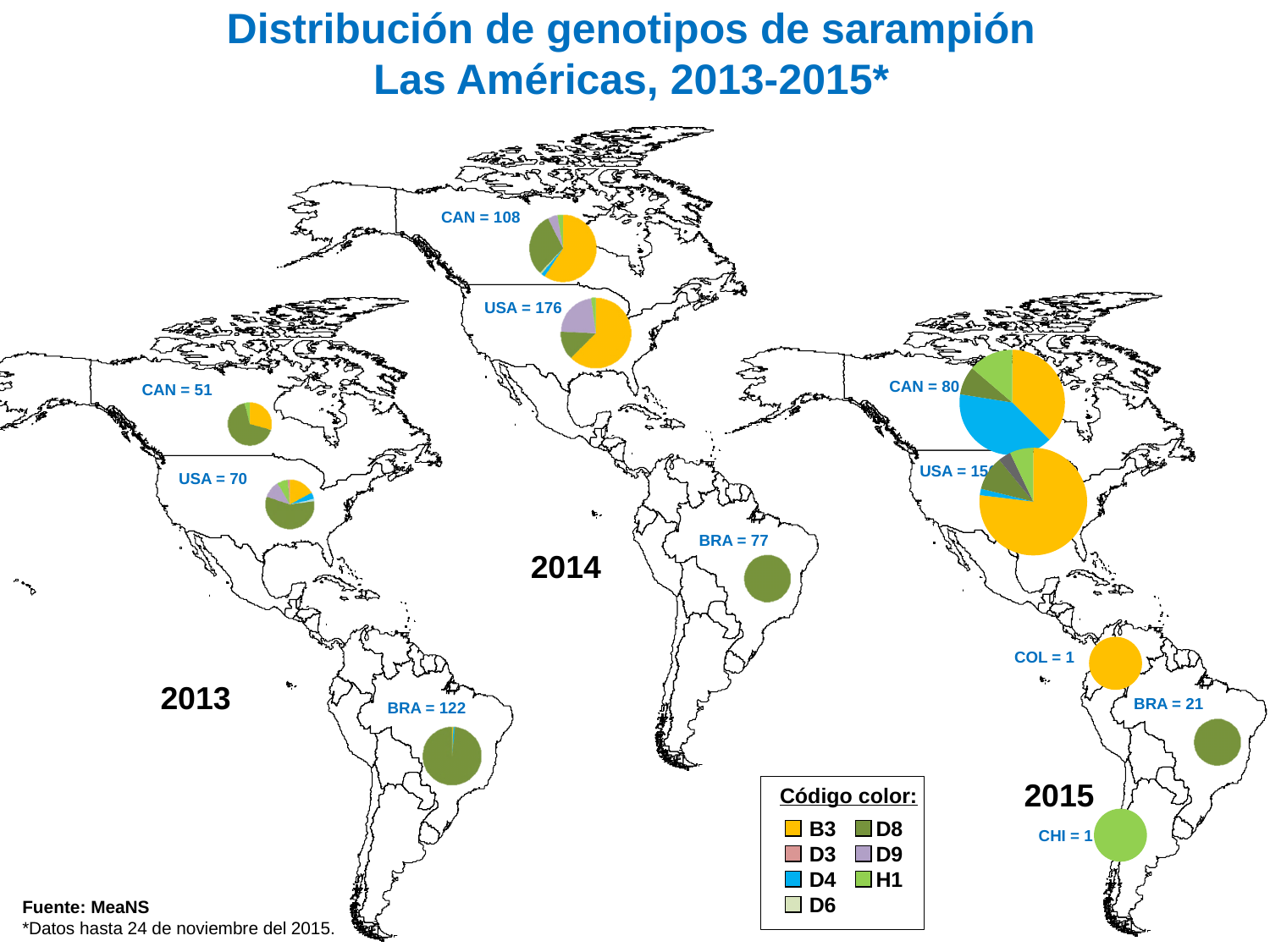
On the 2013 map, what is the number of samples shown for BRA? 122 On the 2013 map, what is the number of samples shown for CAN? 51 What kind of charts are plotted on the maps of the slide? Pie charts On the 2014 map, which genotype makes up the entire BRA pie? D8 How many genotypes are listed in the colour code legend? 7 On the 2015 map, which country has the lowest number of samples, COL or BRA? COL Which is larger, the CAN sample count in 2014 or in 2013? 2014 On the 2014 map, which country has the highest number of samples? USA On the 2015 map, what is the number of samples shown for BRA? 21 On the 2014 map, what is the number of samples shown for USA? 176 What is the difference between the USA sample count in 2014 and in 2013? 106 On the 2015 map, which genotype is the CHI pie coloured as? H1